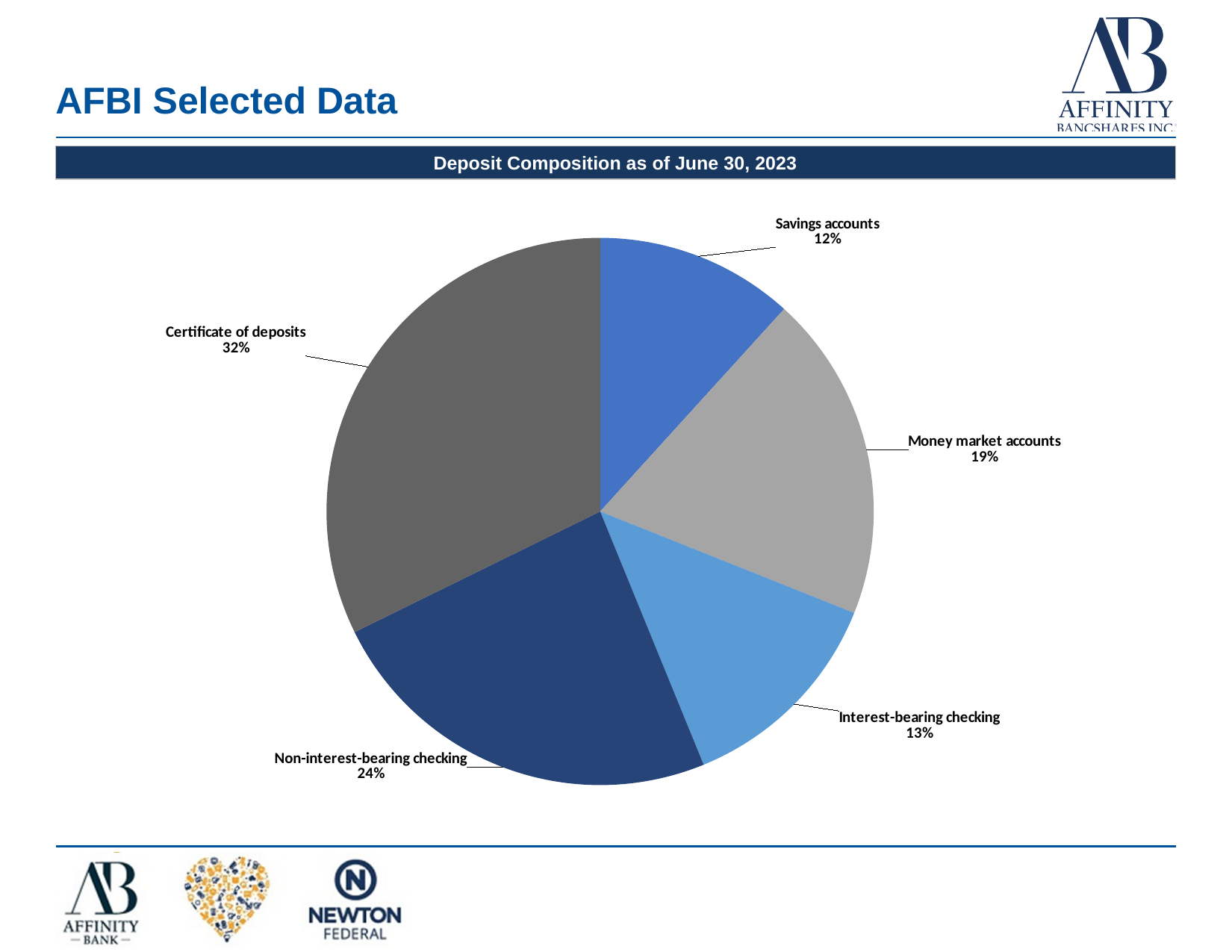
What share of deposits is in non-interest-bearing checking? 24% What kind of chart is shown on the slide? Pie chart What share of deposits is in certificate of deposits? 32% Which deposit category has the smallest share? Savings accounts Which deposit category has the largest share? Certificate of deposits What share of deposits is in savings accounts? 12% Which is larger, the share for money market accounts or the share for interest-bearing checking? Money market accounts What is the title of the chart? Deposit Composition as of June 30, 2023 What is the difference in percentage points between certificate of deposits and non-interest-bearing checking? 8 How many deposit categories are shown in the pie chart? 5